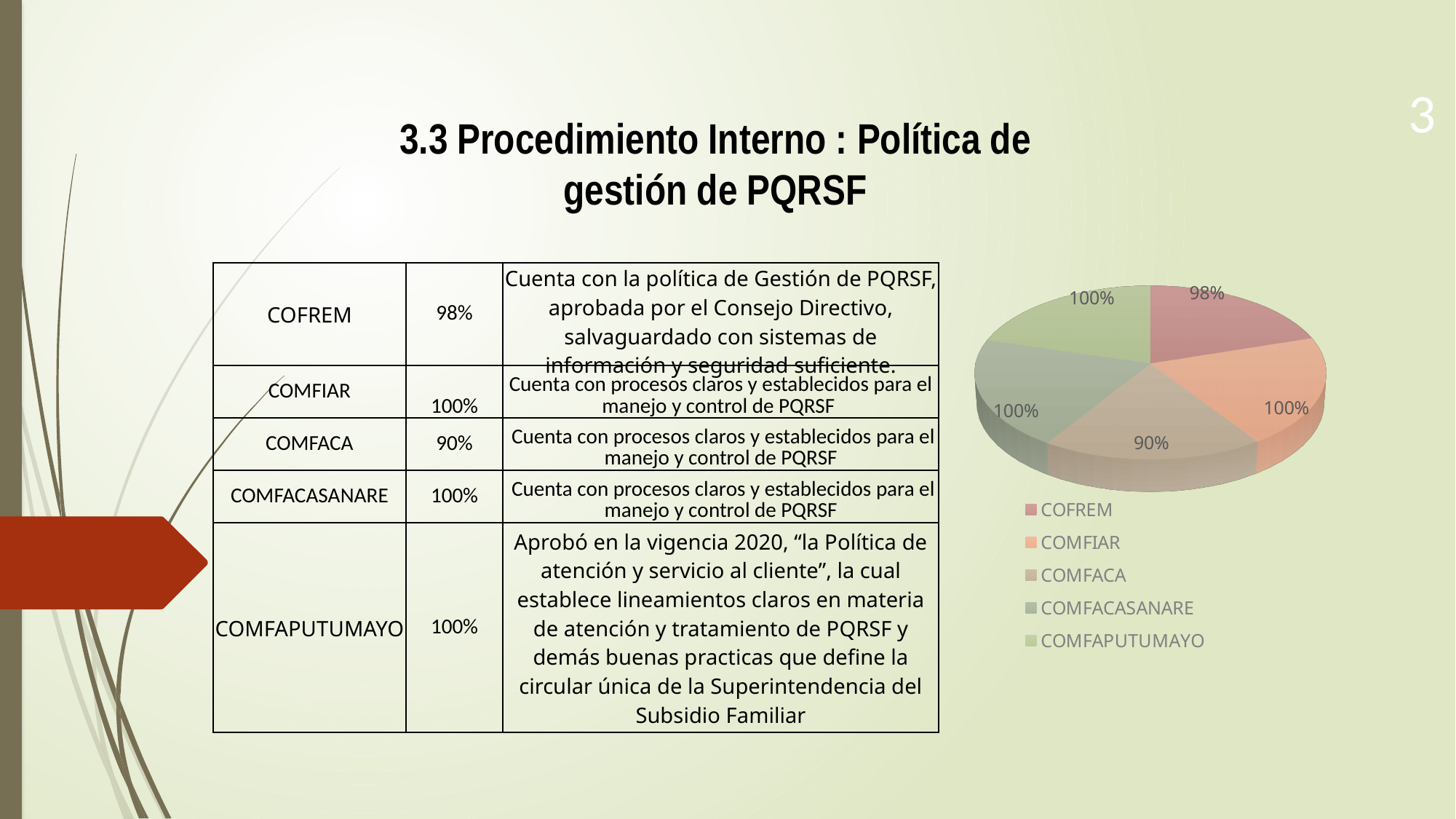
Which category has the lowest value in the pie chart? COMFACA Which has the larger value in the pie chart, COMFIAR or COFREM? COMFIAR What value is shown for COMFAPUTUMAYO in the pie chart? 100% Which has the larger value in the pie chart, COFREM or COMFACA? COFREM What value is shown for COFREM in the pie chart? 98% How many entries does the pie chart legend list? 5 How many slices does the pie chart have? 5 Which legend entry is shown in green in the pie chart? COMFAPUTUMAYO What kind of chart is shown on the slide? pie chart What value is shown for COMFIAR in the pie chart? 100% What value is shown for COMFACA in the pie chart? 90% What is the difference between the values for COFREM and COMFACA in the pie chart? 8%